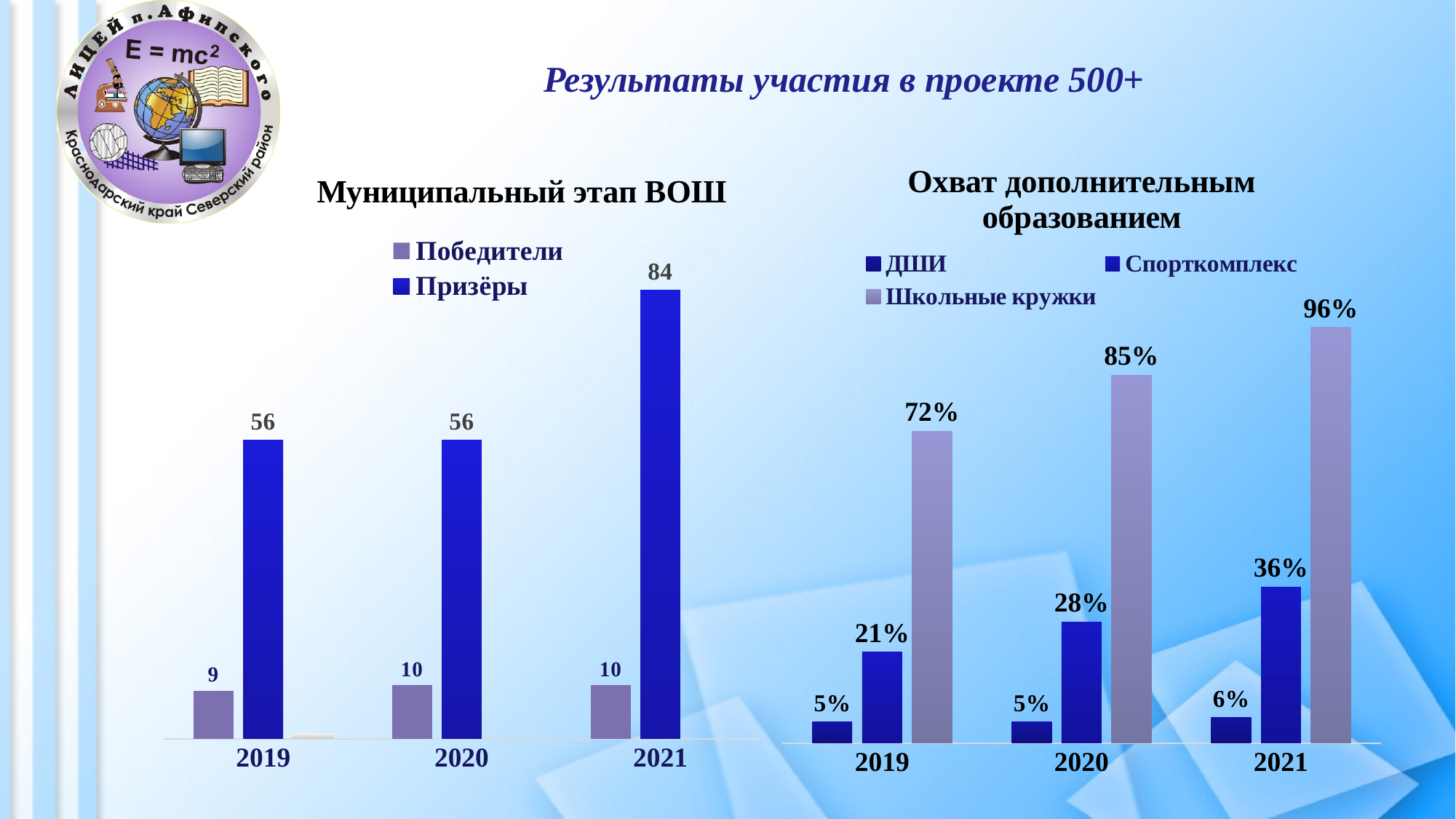
In the 'Муниципальный этап ВОШ' chart, how many series does the legend list? 2 In the 'Охват дополнительным образованием' chart, how does the value for Школьные кружки change from 2019 to 2021? It rises In the 'Муниципальный этап ВОШ' chart, which year has the highest value for Призёры? 2021 In the 'Муниципальный этап ВОШ' chart, what is the value for Призёры in 2021? 84 In the 'Охват дополнительным образованием' chart, what is the value for Школьные кружки in 2020? 85% In the 'Охват дополнительным образованием' chart, which year has the lowest value for Спорткомплекс? 2019 In the 'Охват дополнительным образованием' chart, what is the difference between Школьные кружки in 2021 and 2019? 24% In the 'Муниципальный этап ВОШ' chart, what is the difference between Призёры and Победители in 2020? 46 In the 'Муниципальный этап ВОШ' chart, what is the value for Победители in 2019? 9 What kind of chart is the 'Охват дополнительным образованием' chart? Bar chart In the 'Охват дополнительным образованием' chart, what is the value for Спорткомплекс in 2019? 21% In the 'Охват дополнительным образованием' chart, which is larger in 2021: ДШИ or Спорткомплекс? Спорткомплекс